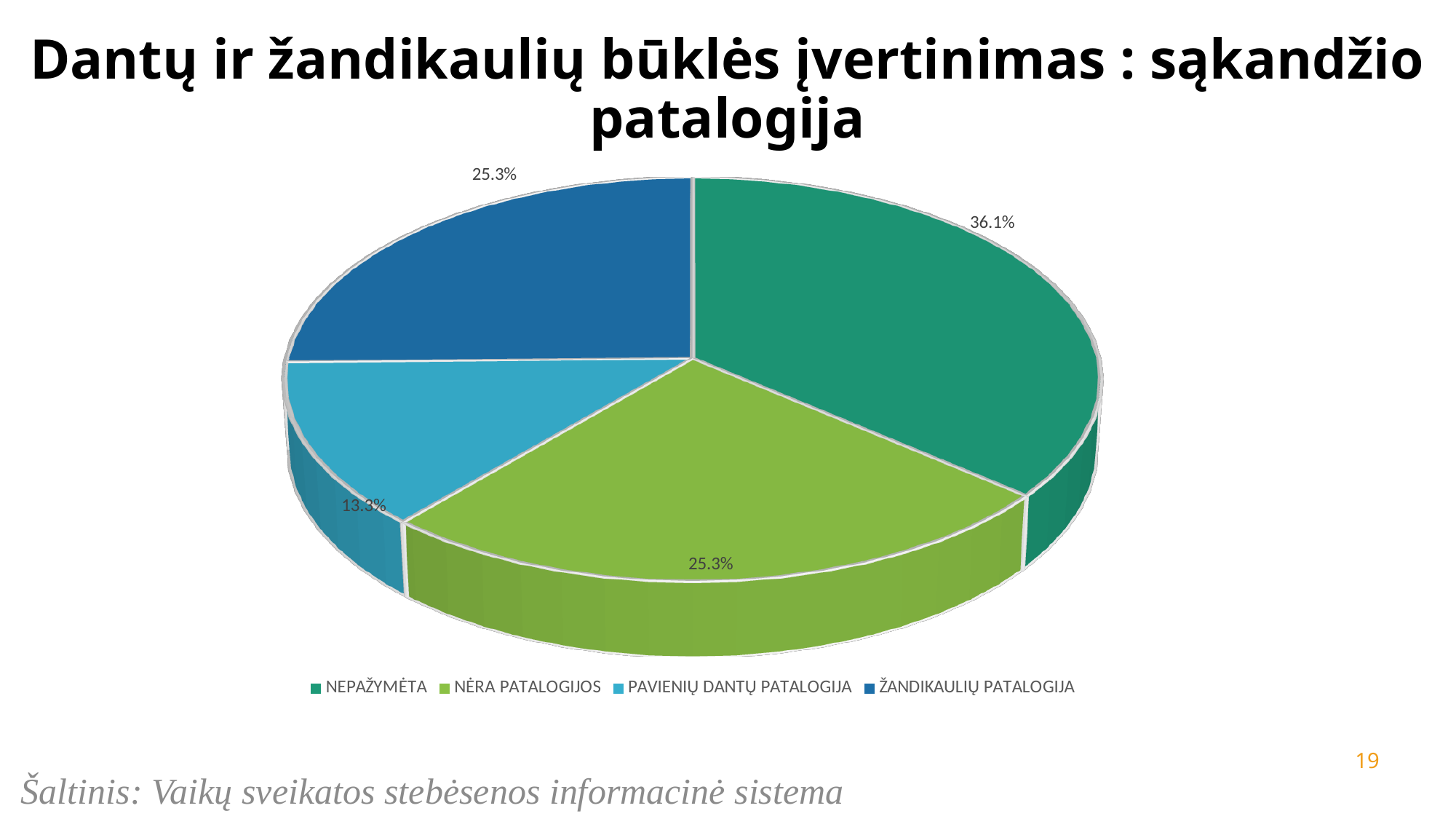
Which category has the largest slice of the pie? NEPAŽYMĖTA What share of the pie does NEPAŽYMĖTA represent? 36.1% Which is larger, the slice for NĖRA PATALOGIJOS or the slice for PAVIENIŲ DANTŲ PATALOGIJA? NĖRA PATALOGIJOS What is the title of the slide containing the chart? Dantų ir žandikaulių būklės įvertinimas : sąkandžio patalogija What share of the pie does PAVIENIŲ DANTŲ PATALOGIJA represent? 13.3% Which category has the smallest slice of the pie? PAVIENIŲ DANTŲ PATALOGIJA What share of the pie does NĖRA PATALOGIJOS represent? 25.3% What type of chart is shown on the slide? Pie chart What is the difference in percentage points between NEPAŽYMĖTA and PAVIENIŲ DANTŲ PATALOGIJA? 22.8 What colour is the slice for ŽANDIKAULIŲ PATALOGIJA? Dark blue What share of the pie does ŽANDIKAULIŲ PATALOGIJA represent? 25.3% How many categories does the pie chart have? 4